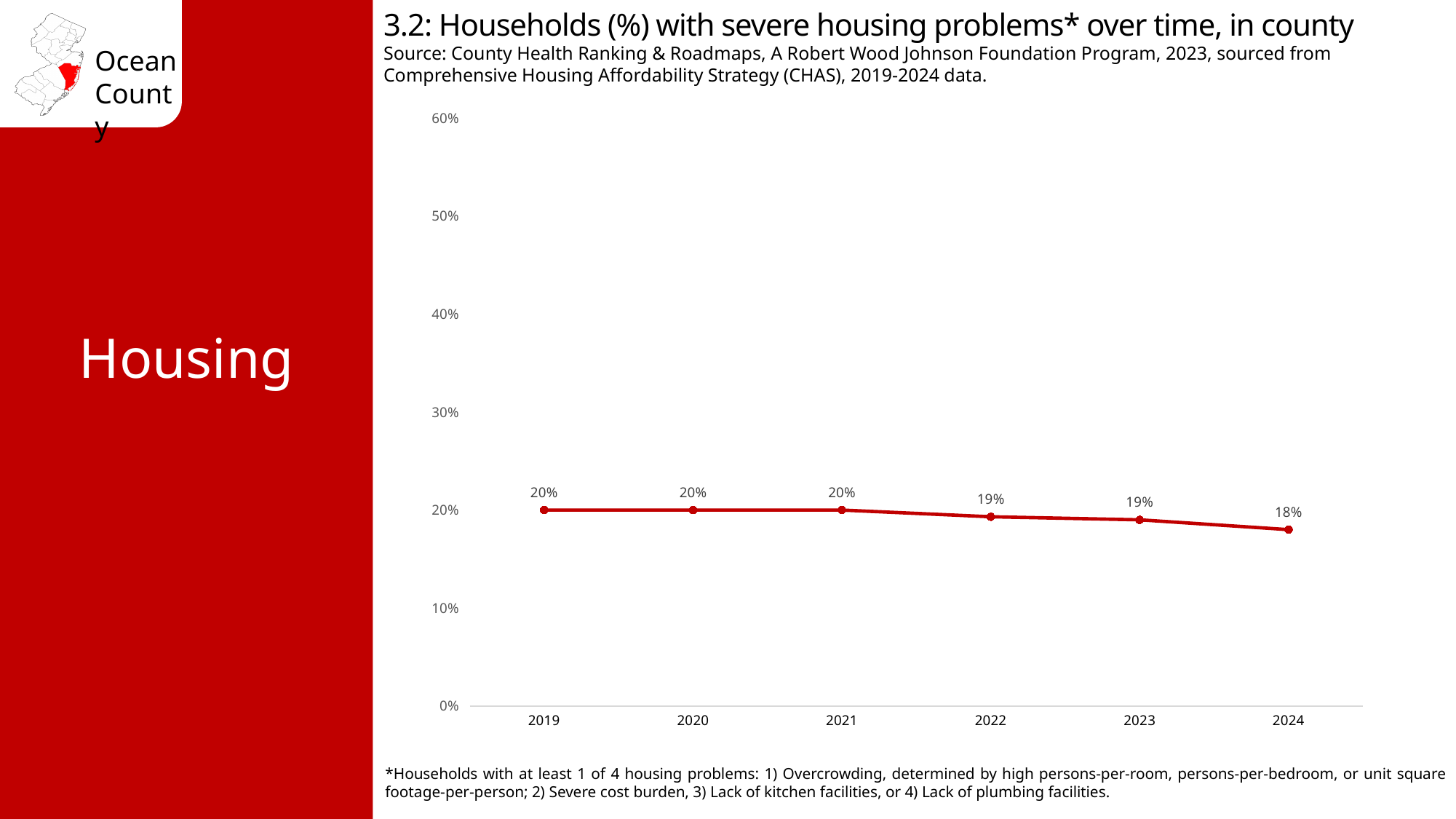
How many years are plotted on the chart? 6 What type of chart is shown on the slide? line chart What is the difference in percentage points between 2019 and 2024? 2 What is the value shown for 2022? 19% What percentage of households had severe housing problems in 2024? 18% Is the value for 2021 larger or smaller than the value for 2024? larger What is the value shown for 2021? 20% Is the value for 2023 greater or less than 30%? less Which year has the lowest percentage of households with severe housing problems? 2024 What percentage of households had severe housing problems in 2019? 20% Do the values rise or fall from 2019 to 2024? fall What is the highest value shown on the y-axis? 60%